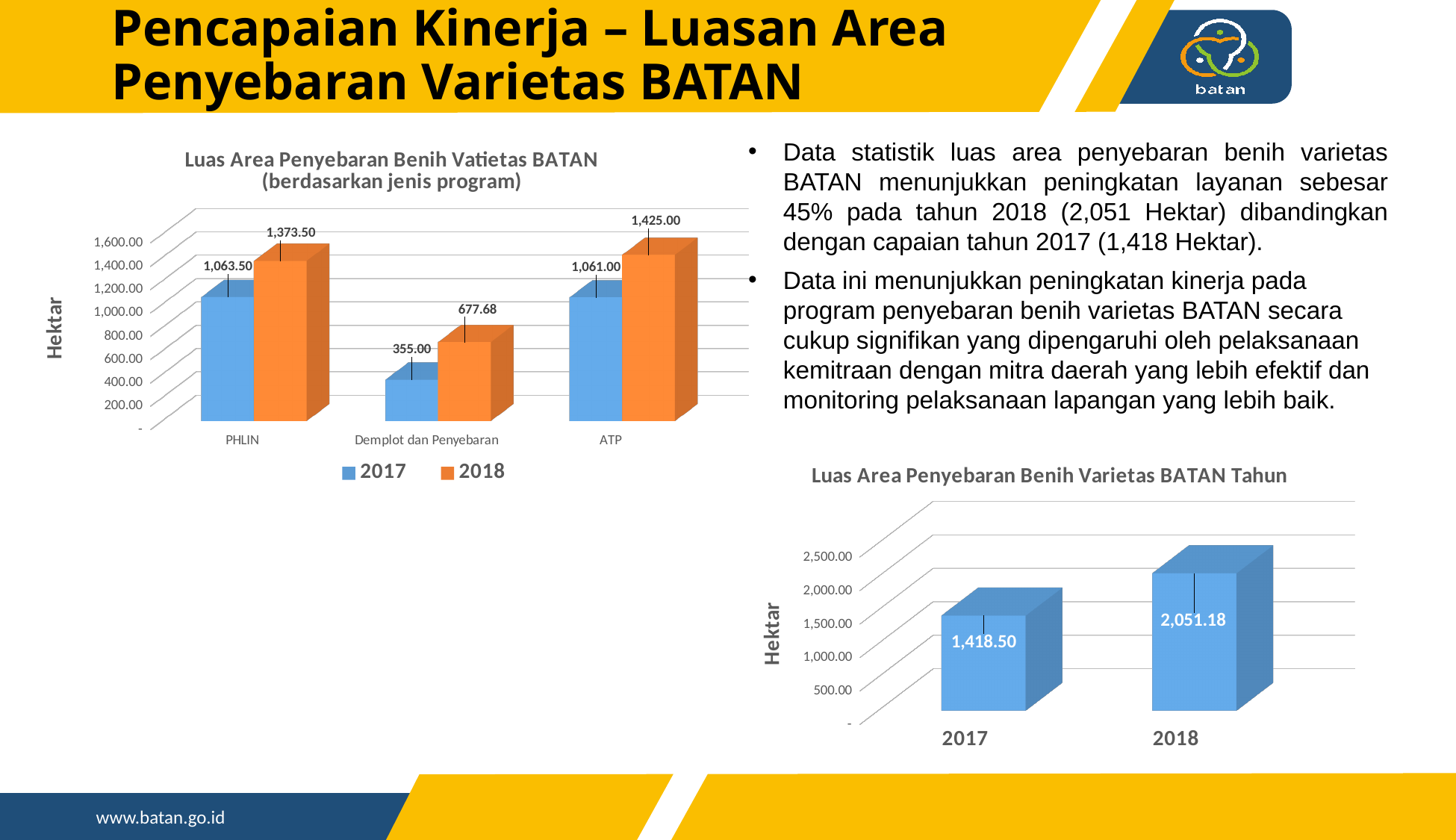
In the left chart (berdasarkan jenis program), what is the 2018 value for PHLIN? 1,373.50 In the left chart (berdasarkan jenis program), what is the 2018 value for ATP? 1,425.00 In the left chart (berdasarkan jenis program), which is larger for Demplot dan Penyebaran: the 2017 value or the 2018 value? 2018 What kind of chart is the right chart (Luas Area Penyebaran Benih Varietas BATAN Tahun)? Bar chart In the left chart (berdasarkan jenis program), how many categories are shown on the x axis? 3 In the right chart (Luas Area Penyebaran Benih Varietas BATAN Tahun), what is the difference between the 2018 and 2017 values? 632.68 In the right chart (Luas Area Penyebaran Benih Varietas BATAN Tahun), what is the value for 2018? 2,051.18 In the left chart (berdasarkan jenis program), what is the 2017 value for Demplot dan Penyebaran? 355.00 In the left chart (berdasarkan jenis program), how many series does the legend list? 2 In the left chart (berdasarkan jenis program), what is the difference between the 2018 and 2017 values for PHLIN? 310.00 In the left chart (berdasarkan jenis program), which category has the lowest 2017 value? Demplot dan Penyebaran In the left chart (berdasarkan jenis program), which category has the highest 2018 value? ATP